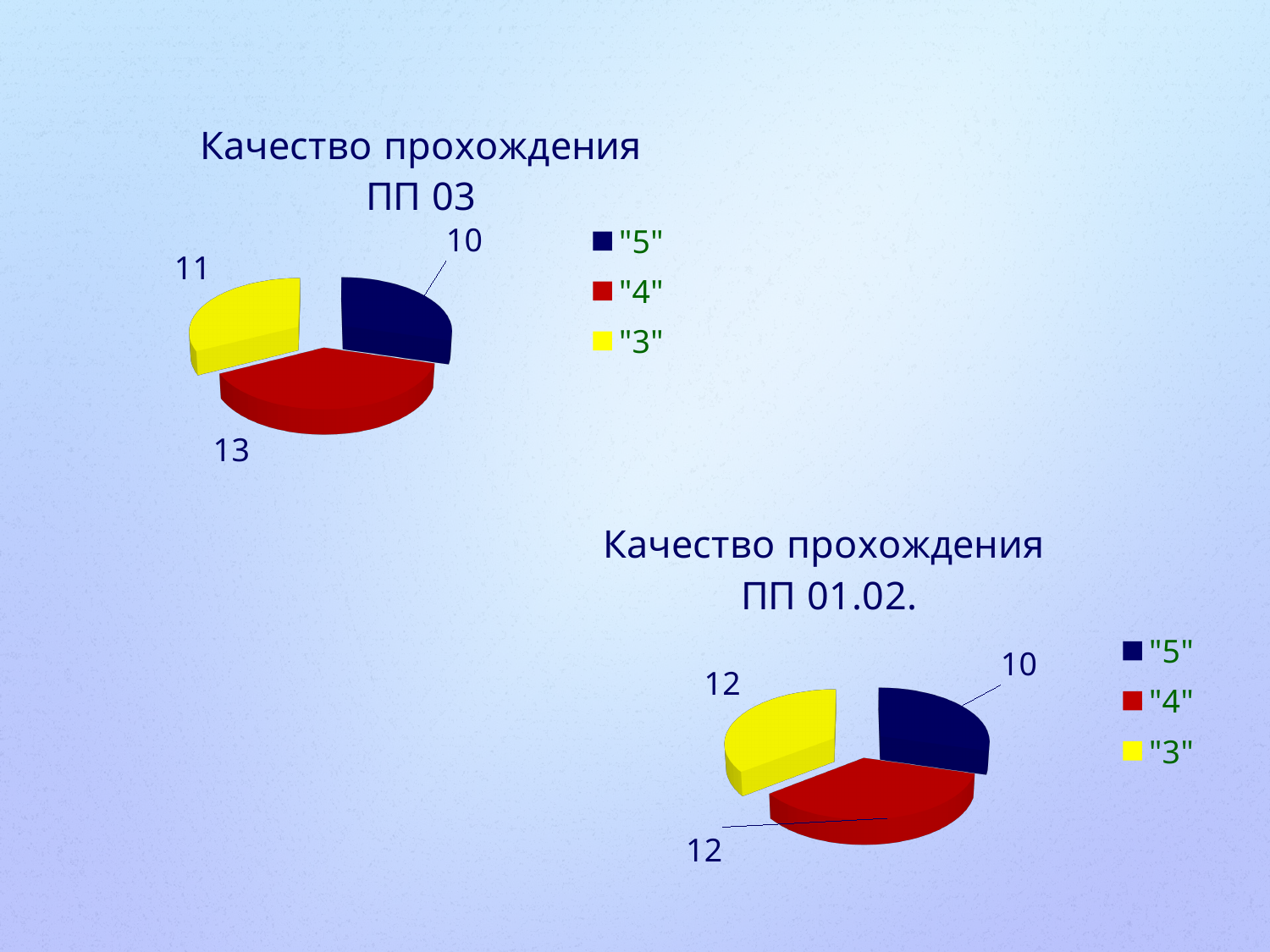
How many categories does the chart titled "Качество прохождения ПП 01.02." show? 3 In the chart titled "Качество прохождения ПП 01.02.", what is the value for "5"? 10 In the chart titled "Качество прохождения ПП 01.02.", which is larger, the value for "4" or the value for "5"? "4" In the chart titled "Качество прохождения ПП 03", what is the value for "3"? 11 What kind of chart is the chart titled "Качество прохождения ПП 03"? Pie chart In the chart titled "Качество прохождения ПП 01.02.", what is the value for "3"? 12 In the chart titled "Качество прохождения ПП 01.02.", which category has the smallest slice? "5" In the chart titled "Качество прохождения ПП 03", which category has the largest slice? "4" In the chart titled "Качество прохождения ПП 03", which category has the smallest slice? "5" In the chart titled "Качество прохождения ПП 03", what is the value for "4"? 13 In the chart titled "Качество прохождения ПП 03", what is the difference between the values for "4" and "5"? 3 In the chart titled "Качество прохождения ПП 03", what colour is the slice for "3"? Yellow